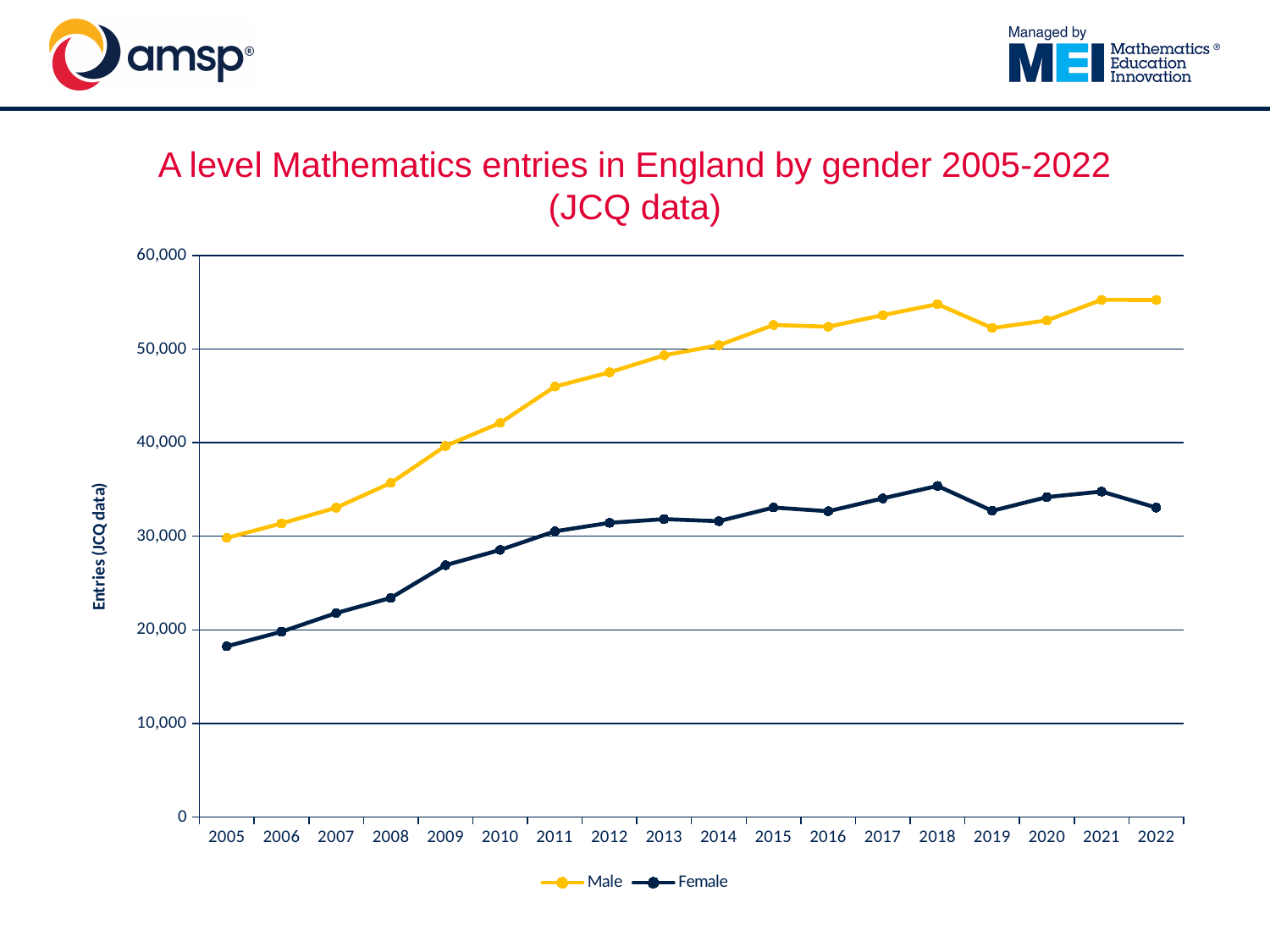
Is the value for Male in 2011 greater or less than 40,000? greater What kind of chart is shown on the slide? Line chart Which year has the lowest value for the Male series? 2005 Do the Male entries generally rise or fall from 2005 to 2022? rise Is the value for Female in 2010 greater or less than 30,000? less In 2015, which series has the larger value, Male or Female? Male Is the value for Female in 2005 greater or less than 20,000? less How many series does the legend list? 2 How many years are plotted along the x axis? 18 Which year has the lowest value for the Female series? 2005